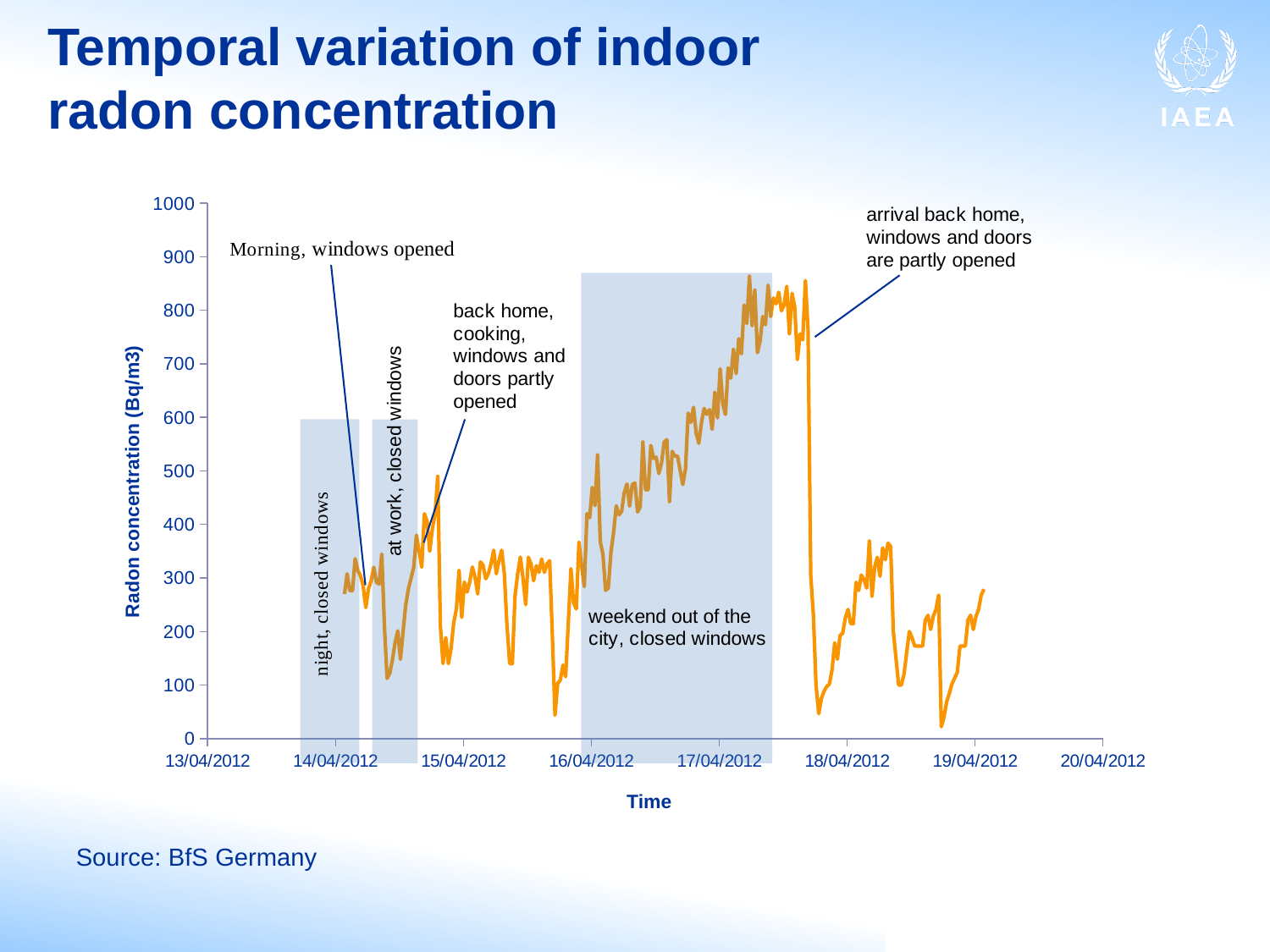
What is the title of the vertical axis of the chart? Radon concentration (Bq/m3) Is the lowest radon concentration reached around 19/04/2012 greater or less than 100? less What label is given to the shaded region between 16/04/2012 and 17/04/2012? weekend out of the city, closed windows Is the peak radon concentration reached around 17/04/2012 greater or less than 900? less Is the peak radon concentration reached around 17/04/2012 greater or less than 800? greater What kind of chart is shown on the slide? line chart Immediately after the point labelled 'arrival back home, windows and doors are partly opened', does the radon concentration rise or fall? fall During the shaded weekend period from 16/04/2012 to 17/04/2012, does the radon concentration rise or fall? rise What is the highest value shown on the vertical axis? 1000 How many date labels are shown on the horizontal axis? 8